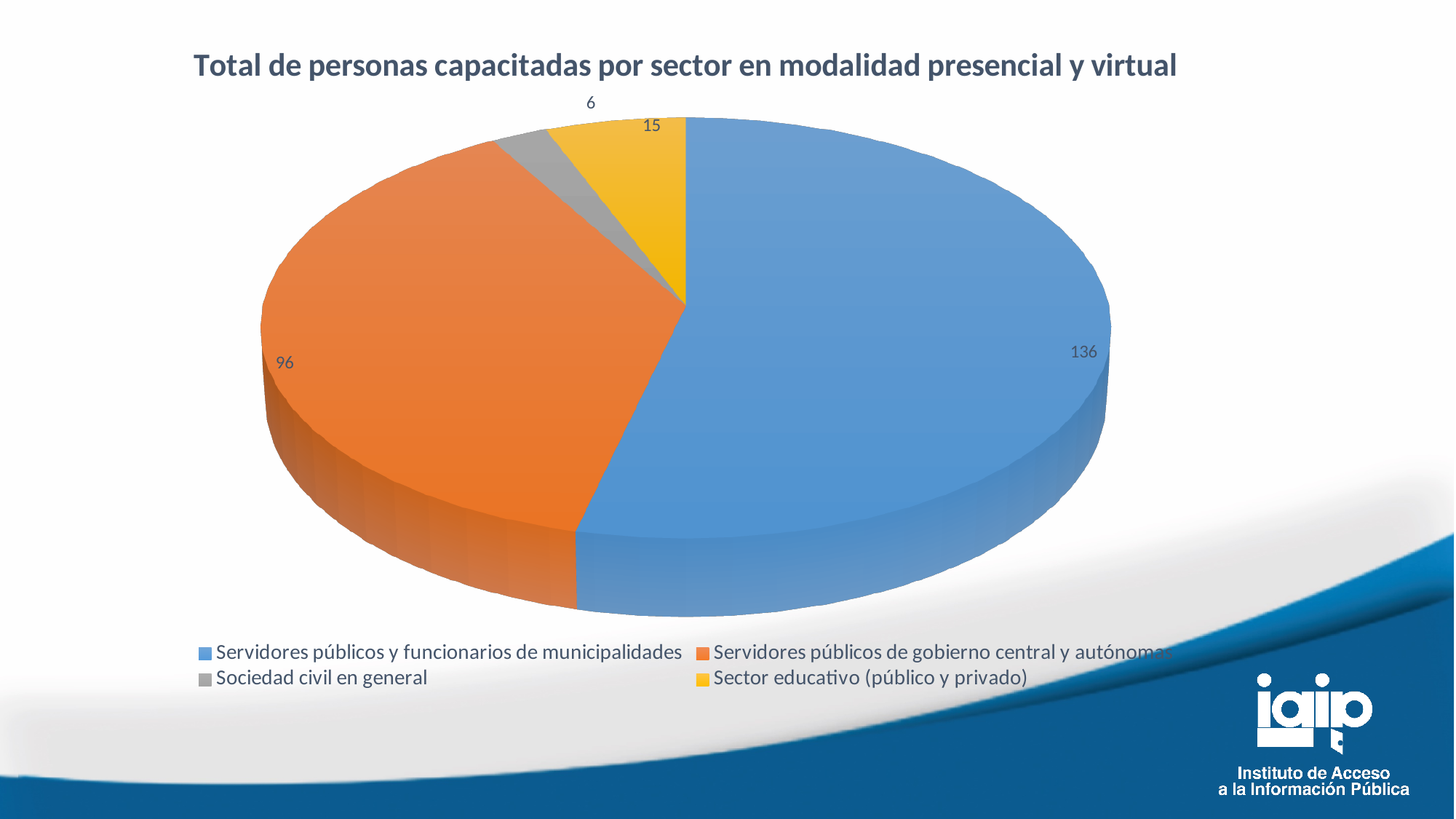
Which sector has the lowest number of people trained? Sociedad civil en general What is the value for Sociedad civil en general? 6 Which sector has the highest number of people trained? Servidores públicos y funcionarios de municipalidades What type of chart is shown on the slide? pie chart How many slices does the pie chart have? 4 What is the title of the chart? Total de personas capacitadas por sector en modalidad presencial y virtual What is the value for Servidores públicos de gobierno central y autónomas? 96 What is the total of all four slices in the pie chart? 253 What is the value for Servidores públicos y funcionarios de municipalidades? 136 What is the difference between Servidores públicos y funcionarios de municipalidades and Servidores públicos de gobierno central y autónomas? 40 What is the value for Sector educativo (público y privado)? 15 Which is larger, Sector educativo (público y privado) or Sociedad civil en general? Sector educativo (público y privado)